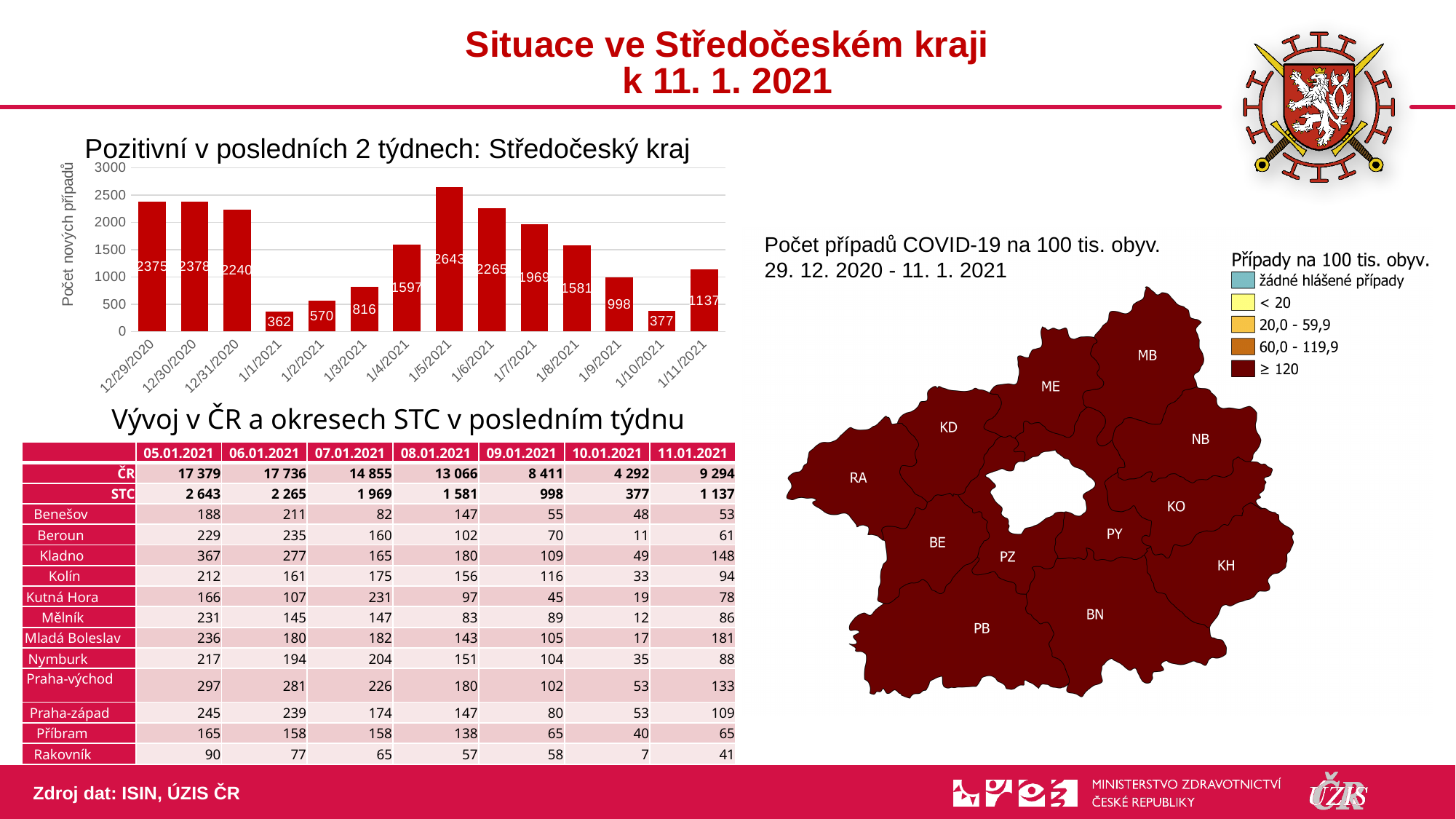
In the chart 'Pozitivní v posledních 2 týdnech: Středočeský kraj', which date has the lowest value? 1/1/2021 In the chart 'Pozitivní v posledních 2 týdnech: Středočeský kraj', which is larger, the value for 1/7/2021 or for 1/8/2021? 1/7/2021 In the chart 'Pozitivní v posledních 2 týdnech: Středočeský kraj', what is the value for 1/5/2021? 2643 In the chart 'Pozitivní v posledních 2 týdnech: Středočeský kraj', do the values rise or fall from 1/5/2021 to 1/10/2021? fall In the chart 'Pozitivní v posledních 2 týdnech: Středočeský kraj', what is the value for 1/2/2021? 570 In the chart 'Pozitivní v posledních 2 týdnech: Středočeský kraj', what is the difference between the values for 1/5/2021 and 1/6/2021? 378 In the chart 'Pozitivní v posledních 2 týdnech: Středočeský kraj', which date has the highest value? 1/5/2021 What is the y-axis title of the chart 'Pozitivní v posledních 2 týdnech: Středočeský kraj'? Počet nových případů In the chart 'Pozitivní v posledních 2 týdnech: Středočeský kraj', what is the value for 1/11/2021? 1137 What kind of chart is 'Pozitivní v posledních 2 týdnech: Středočeský kraj'? bar chart In the chart 'Pozitivní v posledních 2 týdnech: Středočeský kraj', is the value for 1/3/2021 greater or less than 1000? less How many bars are shown in the chart 'Pozitivní v posledních 2 týdnech: Středočeský kraj'? 14